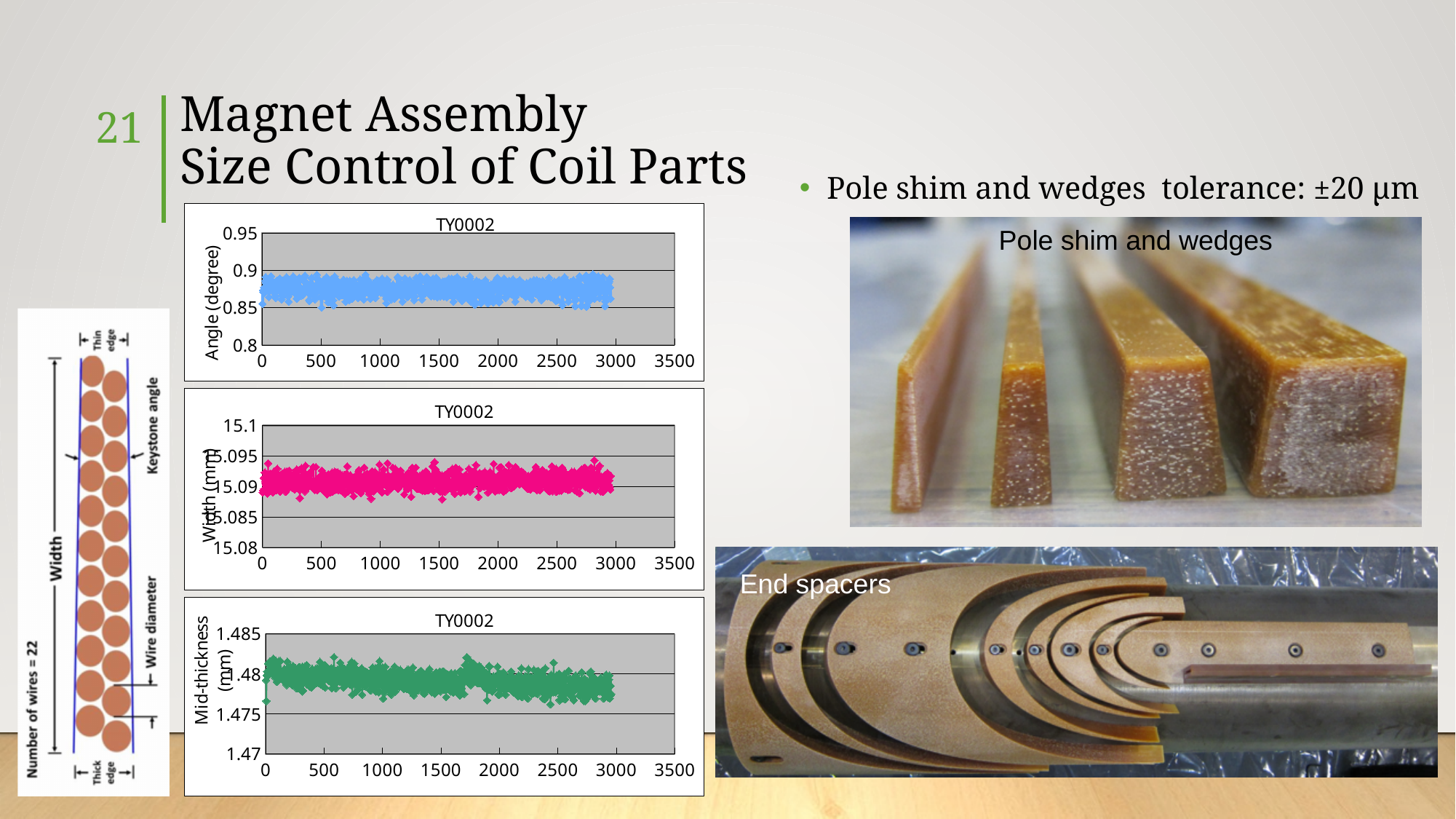
What kind of chart is the top chart on the slide (the one with y-axis 'Angle (degree)')? scatter chart In the top chart (Angle (degree)), are the plotted values greater or less than 0.9? less What is the title of the top chart on the slide? TY0002 In the middle chart (Width (mm)), are the plotted values greater or less than 15.1? less In the bottom chart (Mid-thickness (mm)), do the plotted values rise, fall, or stay roughly flat along the x axis? stay roughly flat What is the y-axis label of the middle chart on the slide? Width (mm) In the middle chart (Width (mm)), are the plotted values greater or less than 15.08? greater How many charts are shown on the slide? 3 What is the maximum value shown on the x axis of the middle chart (Width (mm))? 3500